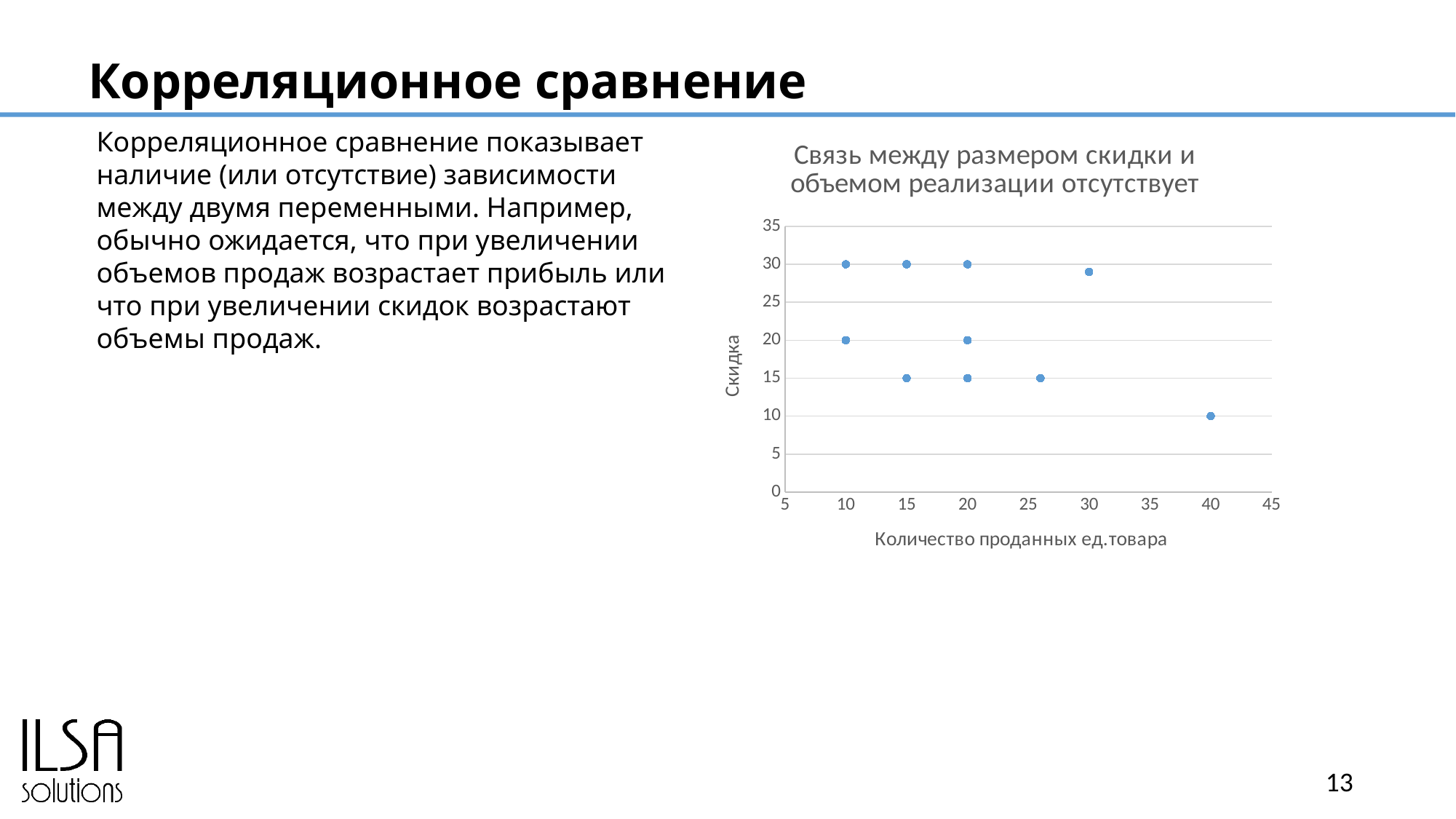
What is the maximum value shown on the vertical axis of the chart? 35 Which has the larger discount: the point at 40 units sold or the point at about 30 units sold? the point at about 30 units sold What is the highest number of units sold (Количество проданных ед.товара) among the plotted points? 40 Is the discount for the point at 40 units sold greater or less than 15? less What is the discount (Скидка) for the point at 40 units sold? 10 How many data points are plotted on the chart? 10 Is the discount for the point at about 30 units sold greater or less than 25? greater What is the label of the vertical axis of the chart? Скидка What is the title of the chart? Связь между размером скидки и объемом реализации отсутствует What is the lowest number of units sold among the plotted points? 10 What kind of chart is shown on the slide? scatter chart What is the lowest discount (Скидка) value among the plotted points? 10